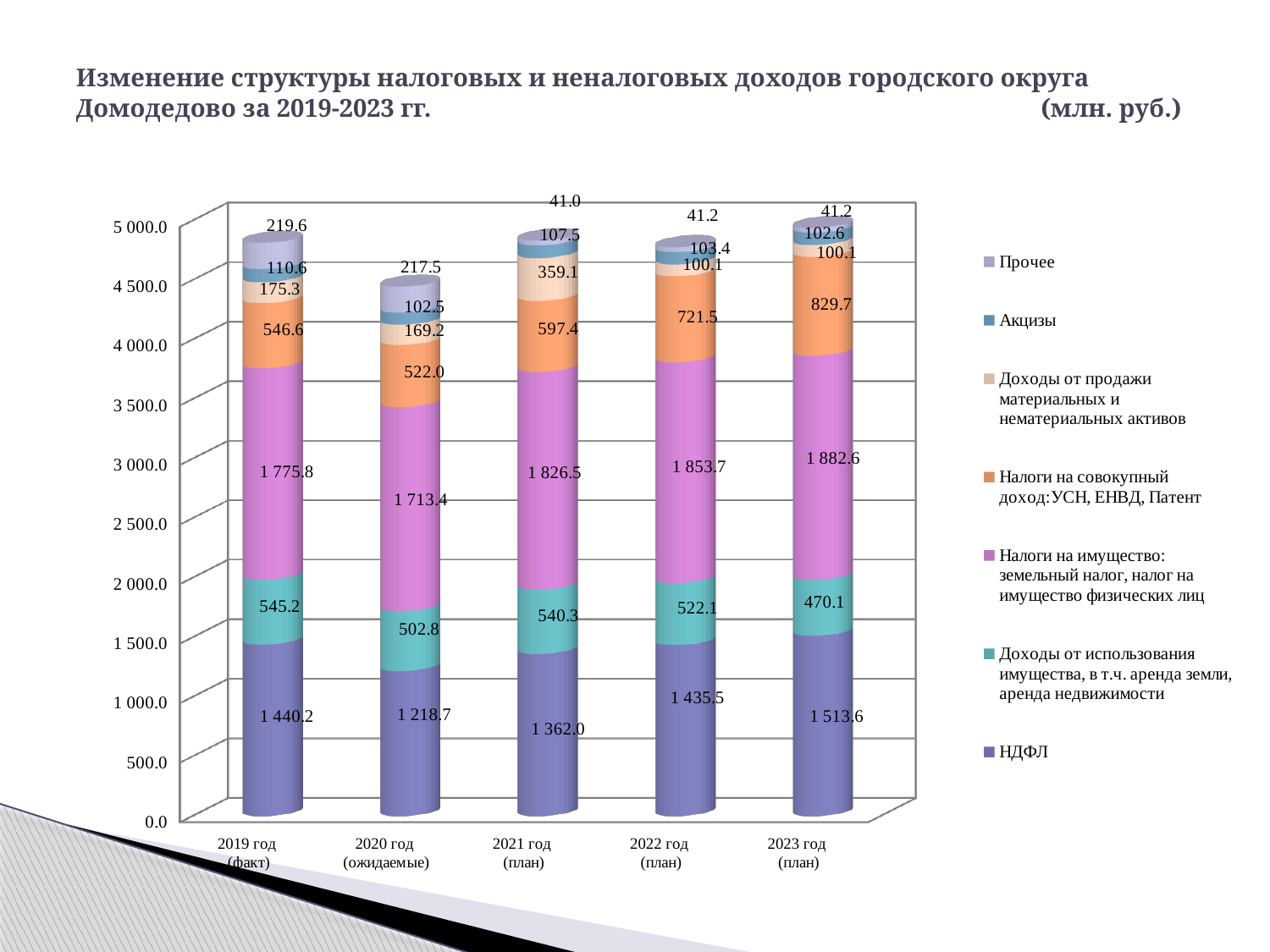
What kind of chart is shown on the slide? Stacked bar chart In which year is the НДФЛ value the highest? 2023 год (план) How many years (categories) are shown on the x axis? 5 What is the value of Акцизы for 2021 год (план)? 107.5 What is the value of Прочее for 2020 год (ожидаемые)? 217.5 What is the value of НДФЛ for 2019 год (факт)? 1 440.2 Does the value of Налоги на совокупный доход rise or fall from 2020 год to 2023 год? Rises What is the difference between the НДФЛ values for 2023 год (план) and 2019 год (факт)? 73.4 In which year is the НДФЛ value the lowest? 2020 год (ожидаемые) What is the value of Налоги на имущество for 2023 год (план)? 1 882.6 Which is larger: Налоги на совокупный доход in 2022 год (план) or in 2021 год (план)? 2022 год (план) How many series does the legend list? 7